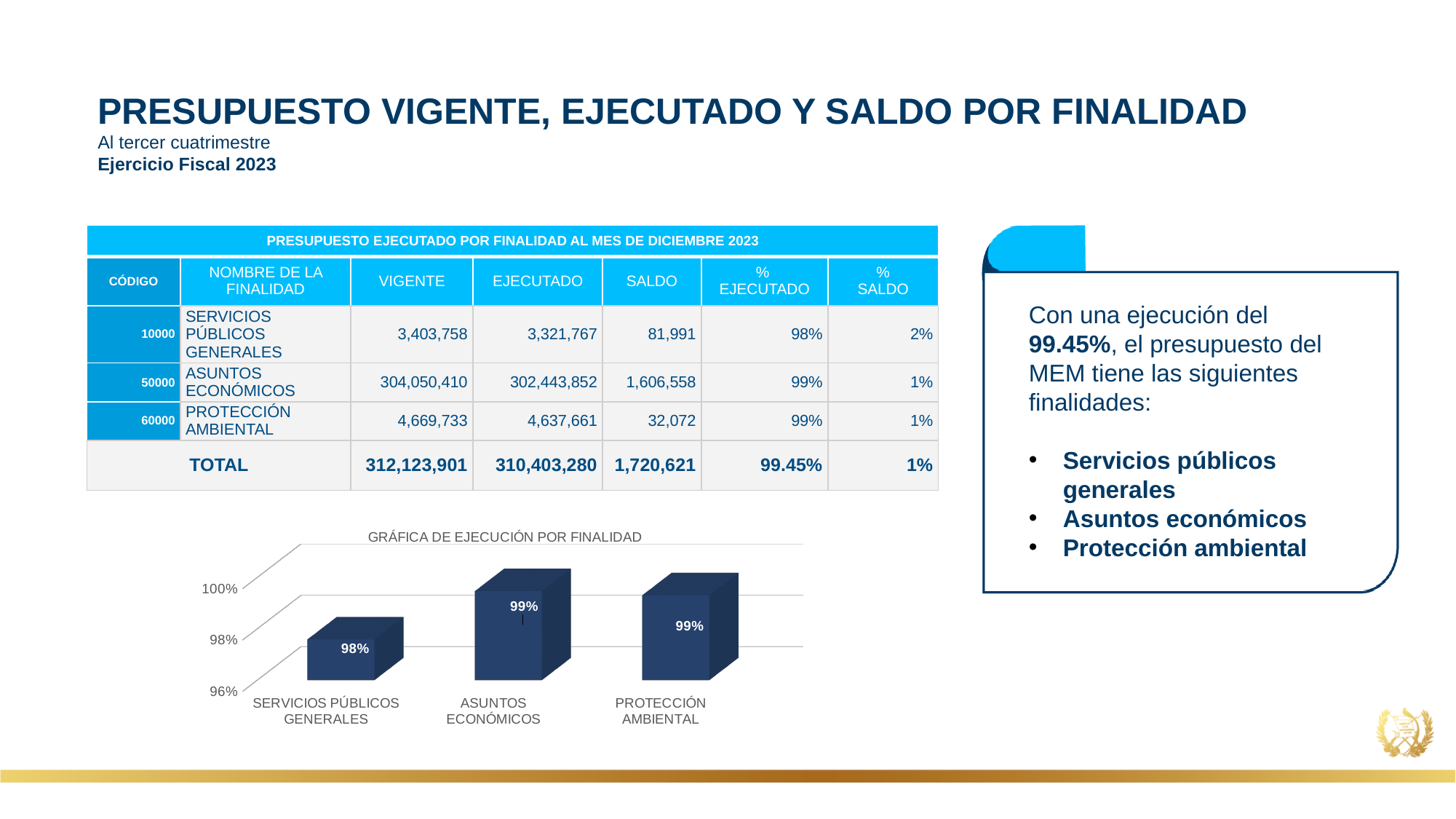
In the chart 'GRÁFICA DE EJECUCIÓN POR FINALIDAD', is the value for SERVICIOS PÚBLICOS GENERALES greater or less than 100%? less In the chart 'GRÁFICA DE EJECUCIÓN POR FINALIDAD', what is the value for SERVICIOS PÚBLICOS GENERALES? 98% What is the title of the chart on the slide? GRÁFICA DE EJECUCIÓN POR FINALIDAD What kind of chart is 'GRÁFICA DE EJECUCIÓN POR FINALIDAD'? Bar chart In the chart 'GRÁFICA DE EJECUCIÓN POR FINALIDAD', what is the difference between the value for PROTECCIÓN AMBIENTAL and the value for SERVICIOS PÚBLICOS GENERALES? 1% In the chart 'GRÁFICA DE EJECUCIÓN POR FINALIDAD', what is the value for PROTECCIÓN AMBIENTAL? 99% How many categories are shown in the chart 'GRÁFICA DE EJECUCIÓN POR FINALIDAD'? 3 In the chart 'GRÁFICA DE EJECUCIÓN POR FINALIDAD', what is the lowest value shown on the vertical axis? 96% In the chart 'GRÁFICA DE EJECUCIÓN POR FINALIDAD', is the value for ASUNTOS ECONÓMICOS greater or less than 98%? greater In the chart 'GRÁFICA DE EJECUCIÓN POR FINALIDAD', which category has the lowest value? SERVICIOS PÚBLICOS GENERALES In the chart 'GRÁFICA DE EJECUCIÓN POR FINALIDAD', what is the value for ASUNTOS ECONÓMICOS? 99% In the chart 'GRÁFICA DE EJECUCIÓN POR FINALIDAD', which is larger: the value for ASUNTOS ECONÓMICOS or the value for SERVICIOS PÚBLICOS GENERALES? ASUNTOS ECONÓMICOS